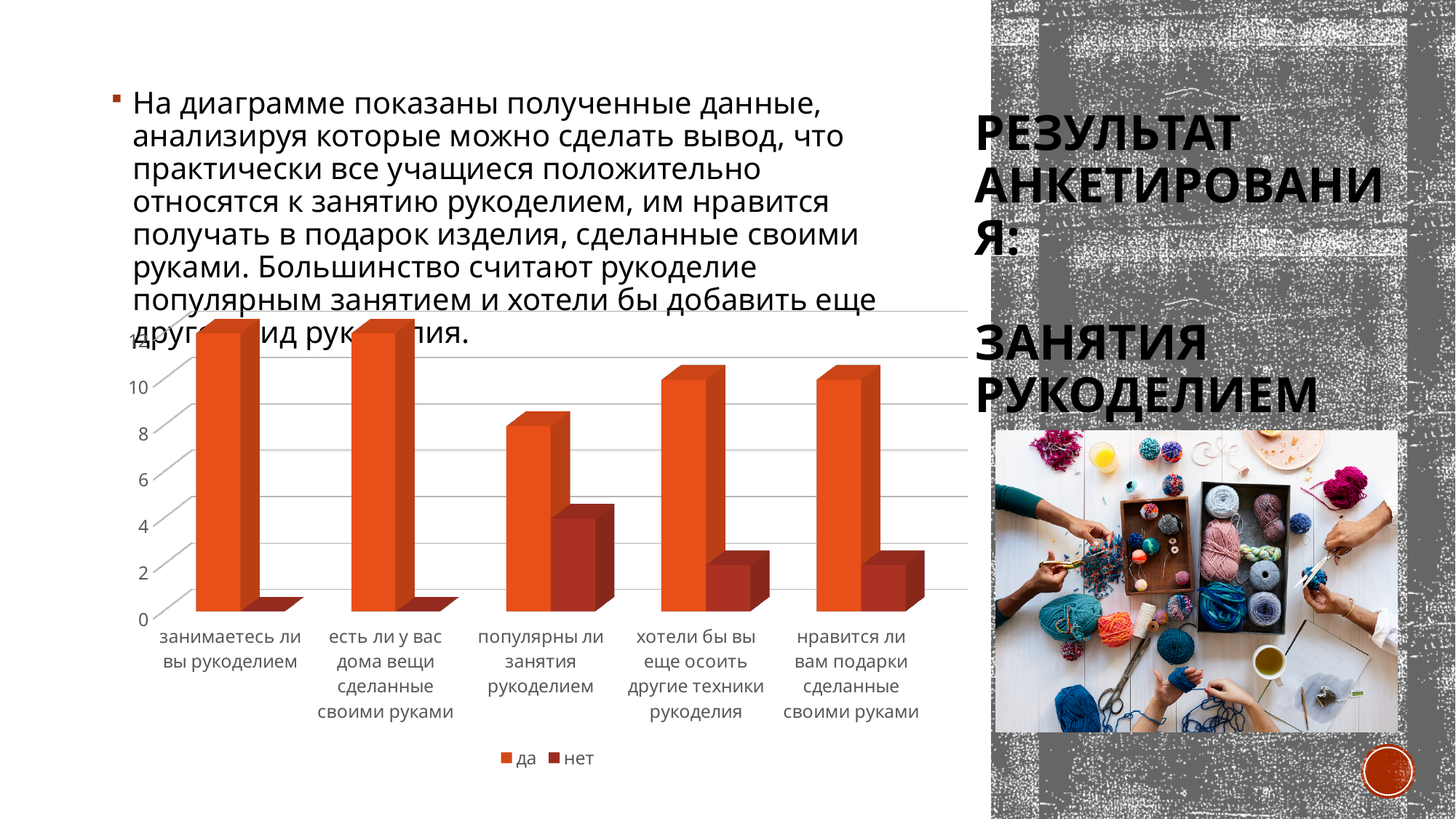
How many series does the chart legend list? 2 Is the value of "нет" for "популярны ли занятия рукоделием" greater or less than 6? less Which category has the lowest "да" value? популярны ли занятия рукоделием Is the value of "да" for "хотели бы вы еще осоить другие техники рукоделия" greater or less than 8? greater How many categories (questions) are shown on the x axis of the chart? 5 For "популярны ли занятия рукоделием", which is larger: the "да" value or the "нет" value? да What kind of chart is shown on the slide? bar chart Which is larger: the "да" value for "занимаетесь ли вы рукоделием" or the "да" value for "популярны ли занятия рукоделием"? занимаетесь ли вы рукоделием Is the value of "да" for "популярны ли занятия рукоделием" greater or less than 10? less What are the two series named in the chart legend? да and нет Which category has the highest "нет" value? популярны ли занятия рукоделием